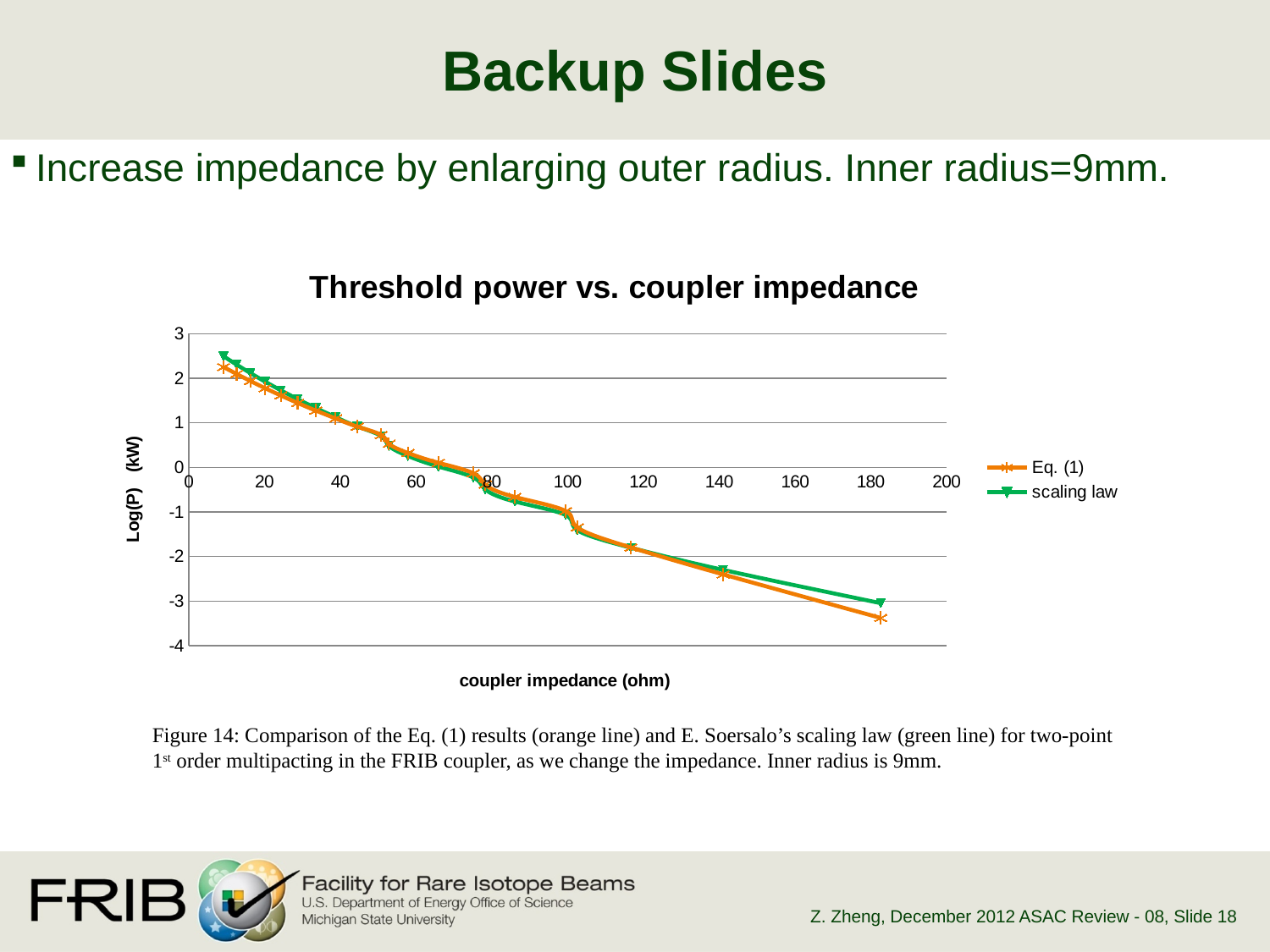
Is the Eq. (1) value at a coupler impedance of about 60 ohm greater or less than 0? greater What is the title of the chart? Threshold power vs. coupler impedance At the lowest plotted impedance (around 10 ohm), which series has the larger Log(P) value, Eq. (1) or scaling law? scaling law Is the Eq. (1) value at the highest plotted impedance (around 180 ohm) greater or less than -3? less Is the Eq. (1) value at the lowest plotted impedance (around 10 ohm) greater or less than 2? greater At the highest plotted impedance (around 180 ohm), which series has the larger Log(P) value, Eq. (1) or scaling law? scaling law What is the label of the x axis? coupler impedance (ohm) Do the values of the Eq. (1) series rise or fall as coupler impedance increases? fall Do the values of the scaling law series rise or fall as coupler impedance increases? fall What kind of chart is shown on the slide? line chart How many series does the legend list? 2